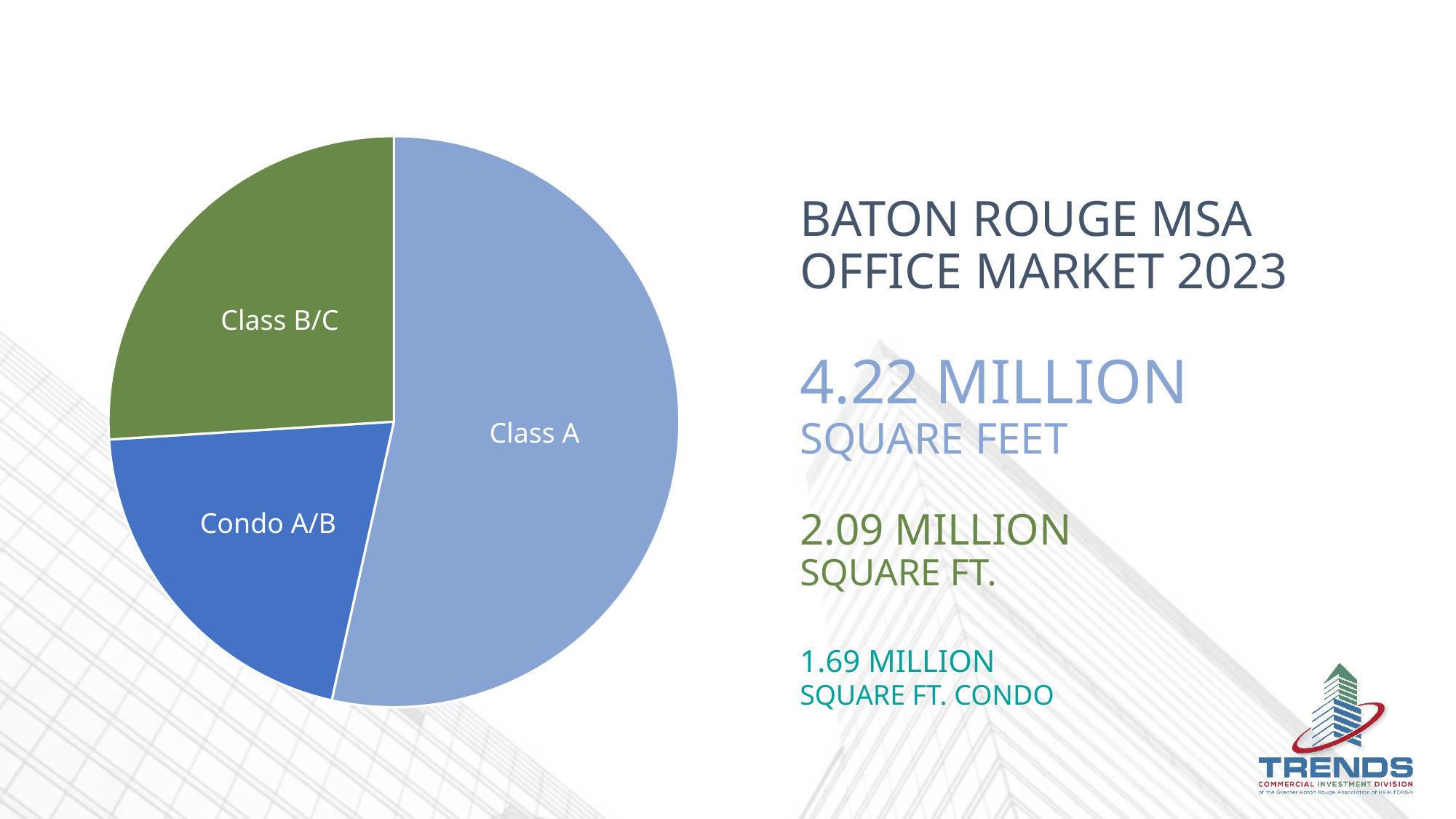
What kind of chart is shown on the slide? pie chart How many square feet does the slide give for Class A office space? 4.22 million square feet What is the title shown next to the pie chart? Baton Rouge MSA Office Market 2023 How many slices does the pie chart have? 3 Which slice is larger, Class B/C or Condo A/B? Class B/C How many square feet does the slide give for condo office space? 1.69 million square ft. By how many million square feet does Class A exceed Class B/C? 2.13 million Which slice of the pie chart is the largest? Class A Does the Class A slice account for more or less than half of the pie? more How many square feet does the slide give for Class B/C office space? 2.09 million square ft. What colour is the Class B/C slice of the pie chart? green Which slice of the pie chart is the smallest? Condo A/B